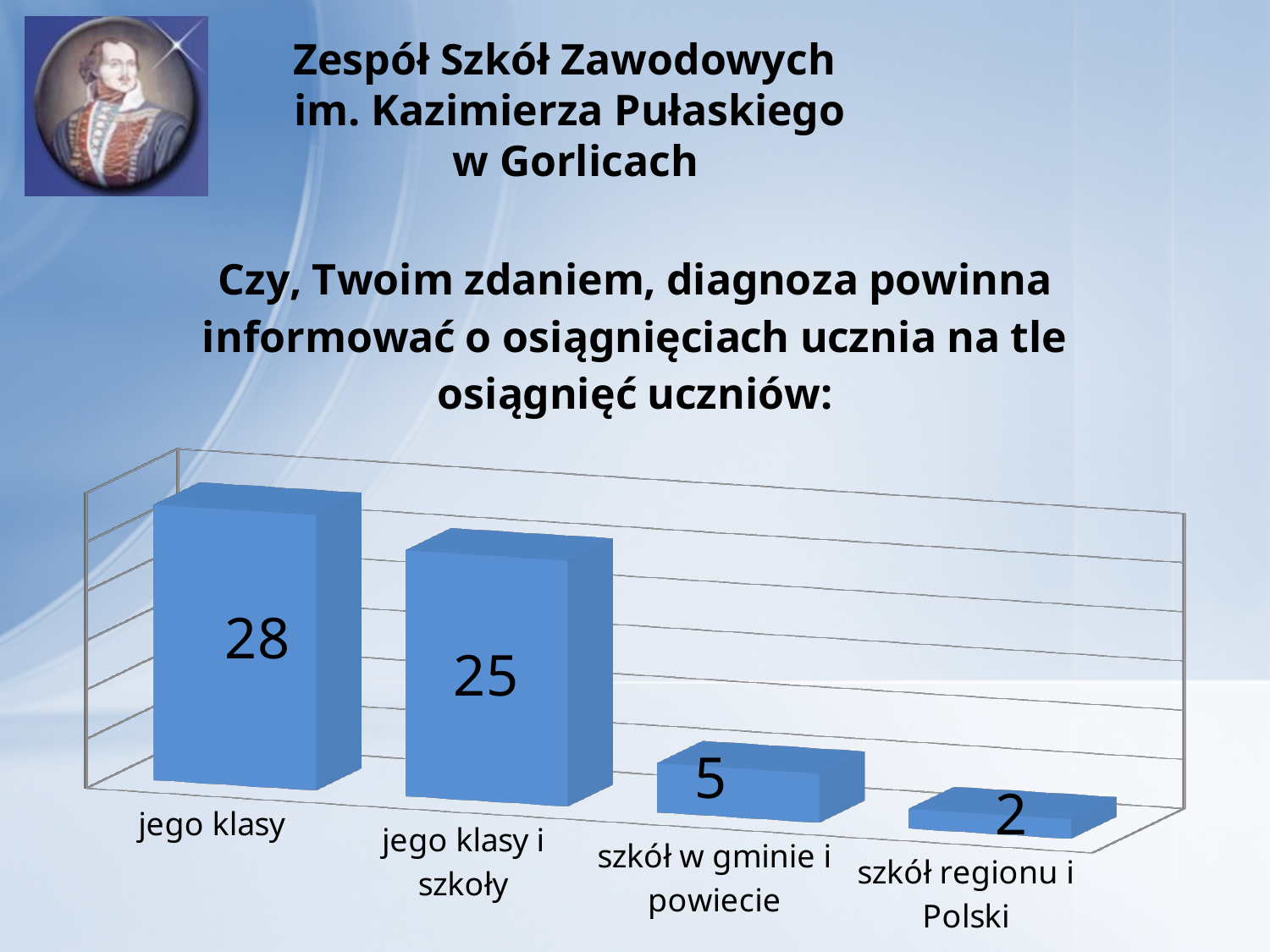
What is the value for "szkół regionu i Polski"? 2 What is the value for "szkół w gminie i powiecie"? 5 What is the value for "jego klasy i szkoły"? 25 What kind of chart is shown on the slide? bar chart Do the values rise or fall from left to right along the x axis? fall What is the difference between the values for "szkół w gminie i powiecie" and "szkół regionu i Polski"? 3 Which is larger, the value for "jego klasy i szkoły" or the value for "szkół w gminie i powiecie"? jego klasy i szkoły Which category has the lowest value? szkół regionu i Polski What is the value for "jego klasy"? 28 How many categories are shown in the chart? 4 What is the difference between the values for "jego klasy" and "jego klasy i szkoły"? 3 Which category has the highest value? jego klasy